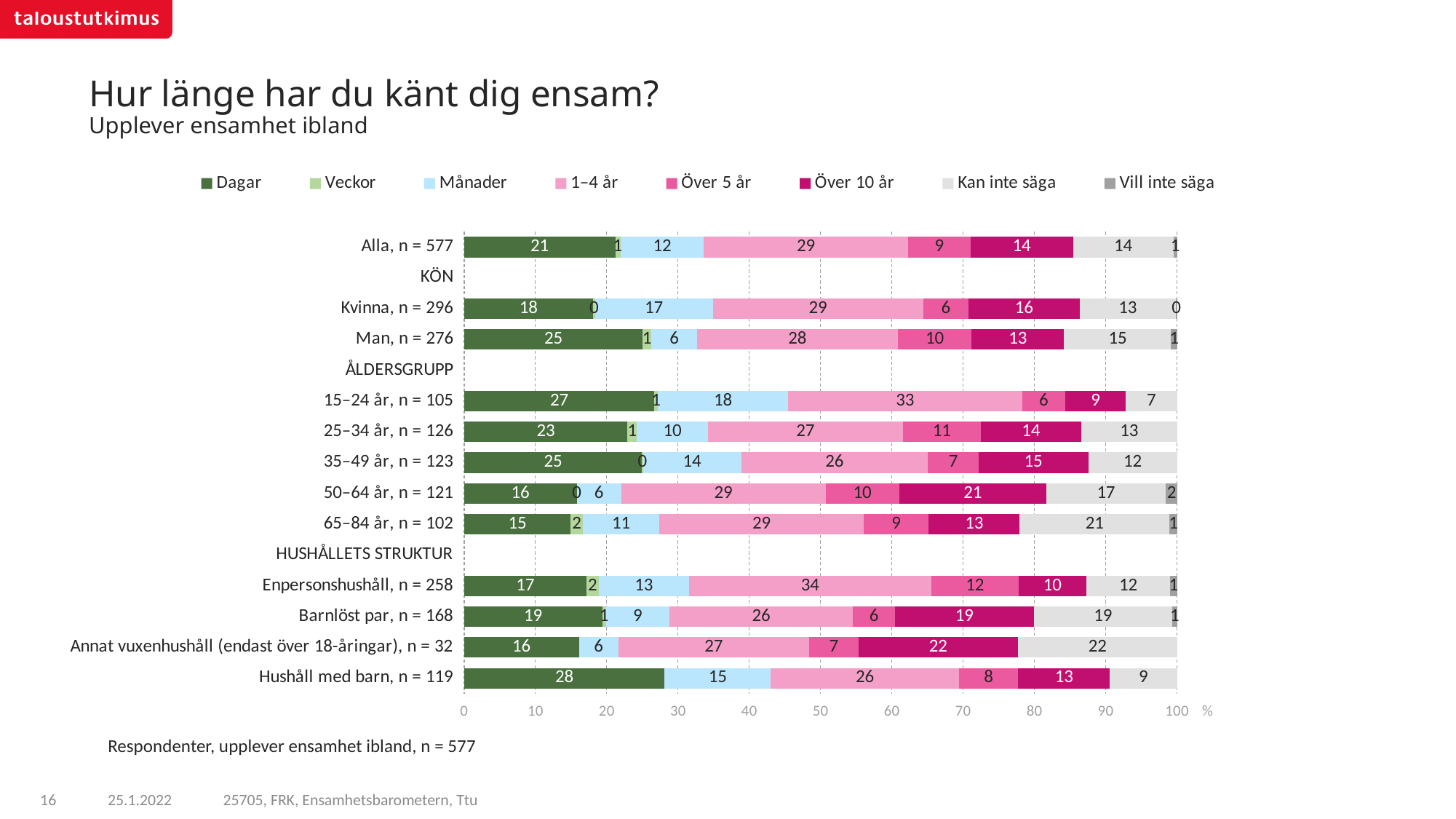
Which group has the highest value for Dagar? Hushåll med barn, n = 119 What is the value for Över 10 år in the 50–64 år, n = 121 bar? 21 What is the title of the chart? Hur länge har du känt dig ensam? What is the value for Månader in the Kvinna, n = 296 bar? 17 What is the difference between the Dagar values for Man, n = 276 and Kvinna, n = 296? 7 What kind of chart is shown on the slide? Stacked bar chart Which has the larger value for Över 10 år, Kvinna, n = 296 or Man, n = 276? Kvinna, n = 296 How many series does the legend list? 8 Which group has the lowest value for Kan inte säga? 15–24 år, n = 105 What is the value for Dagar in the Hushåll med barn, n = 119 bar? 28 Which group has the highest value for 1–4 år? Enpersonshushåll, n = 258 What is the difference between the Kan inte säga values for 65–84 år, n = 102 and Alla, n = 577? 7